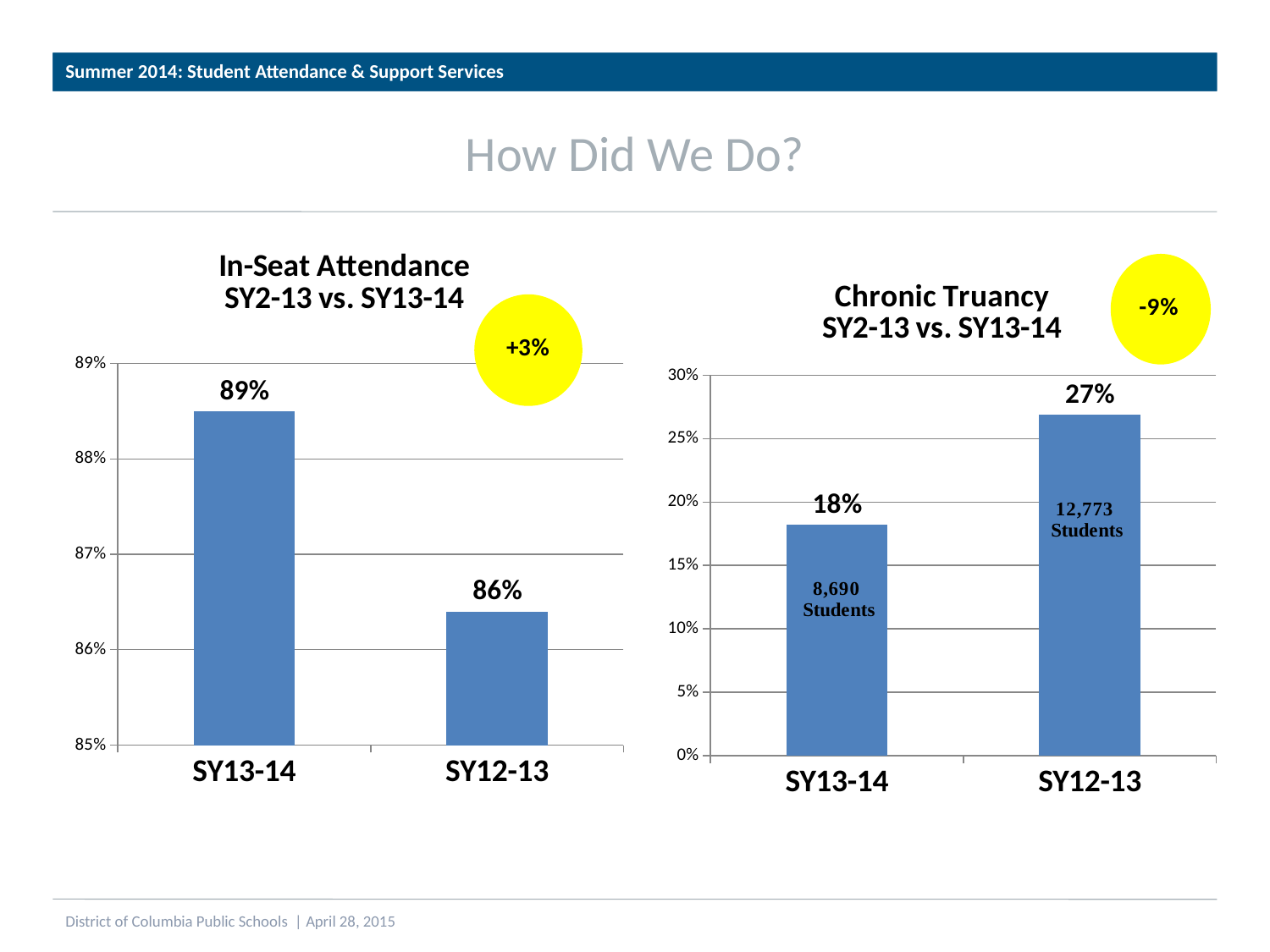
In the Chronic Truancy chart, how many students does the SY12-13 bar represent? 12,773 Students In the In-Seat Attendance chart, what is the difference between the SY13-14 and SY12-13 values? 3% In the In-Seat Attendance chart, what is the value for SY12-13? 86% How many bars are in the In-Seat Attendance chart? 2 In the Chronic Truancy chart, what is the percentage for SY13-14? 18% In the In-Seat Attendance chart, what is the value for SY13-14? 89% In the Chronic Truancy chart, which school year has the lower truancy rate? SY13-14 In the Chronic Truancy chart, what is the percentage for SY12-13? 27% In the Chronic Truancy chart, how many students does the SY13-14 bar represent? 8,690 Students What kind of chart is the Chronic Truancy chart? Bar chart In the Chronic Truancy chart, what is the difference between the SY12-13 and SY13-14 percentages? 9% In the In-Seat Attendance chart, which school year has the higher attendance? SY13-14